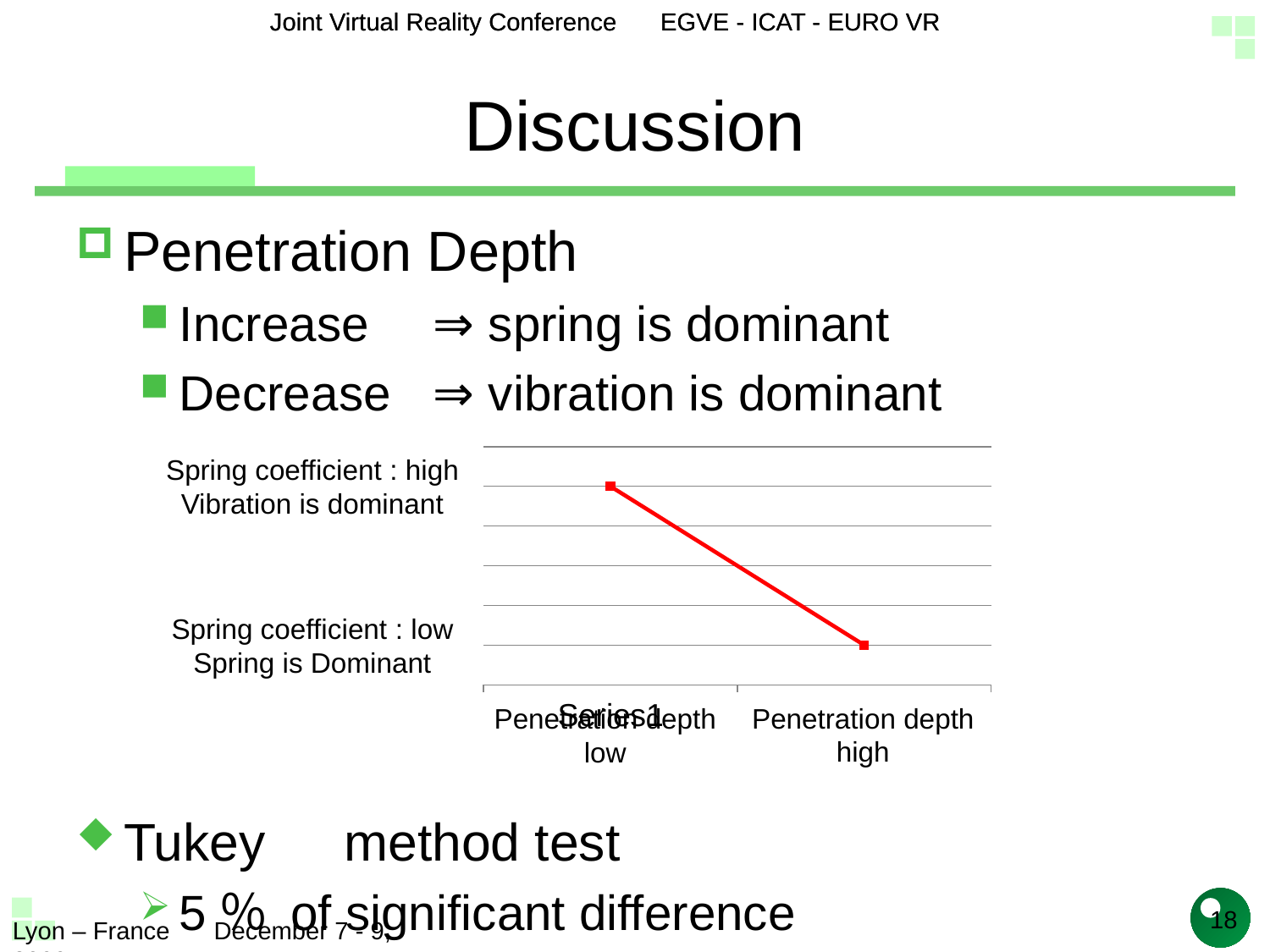
What kind of chart is shown on the slide? line chart Which category has the highest plotted value? Penetration depth low Which category has the lowest plotted value? Penetration depth high How many categories are plotted on the x axis of the chart? 2 What colour is the line plotted in the chart? red What is the label of the first category on the x axis? Penetration depth low Which category has the higher plotted value, 'Penetration depth low' or 'Penetration depth high'? Penetration depth low Do the plotted values rise or fall from 'Penetration depth low' to 'Penetration depth high'? fall